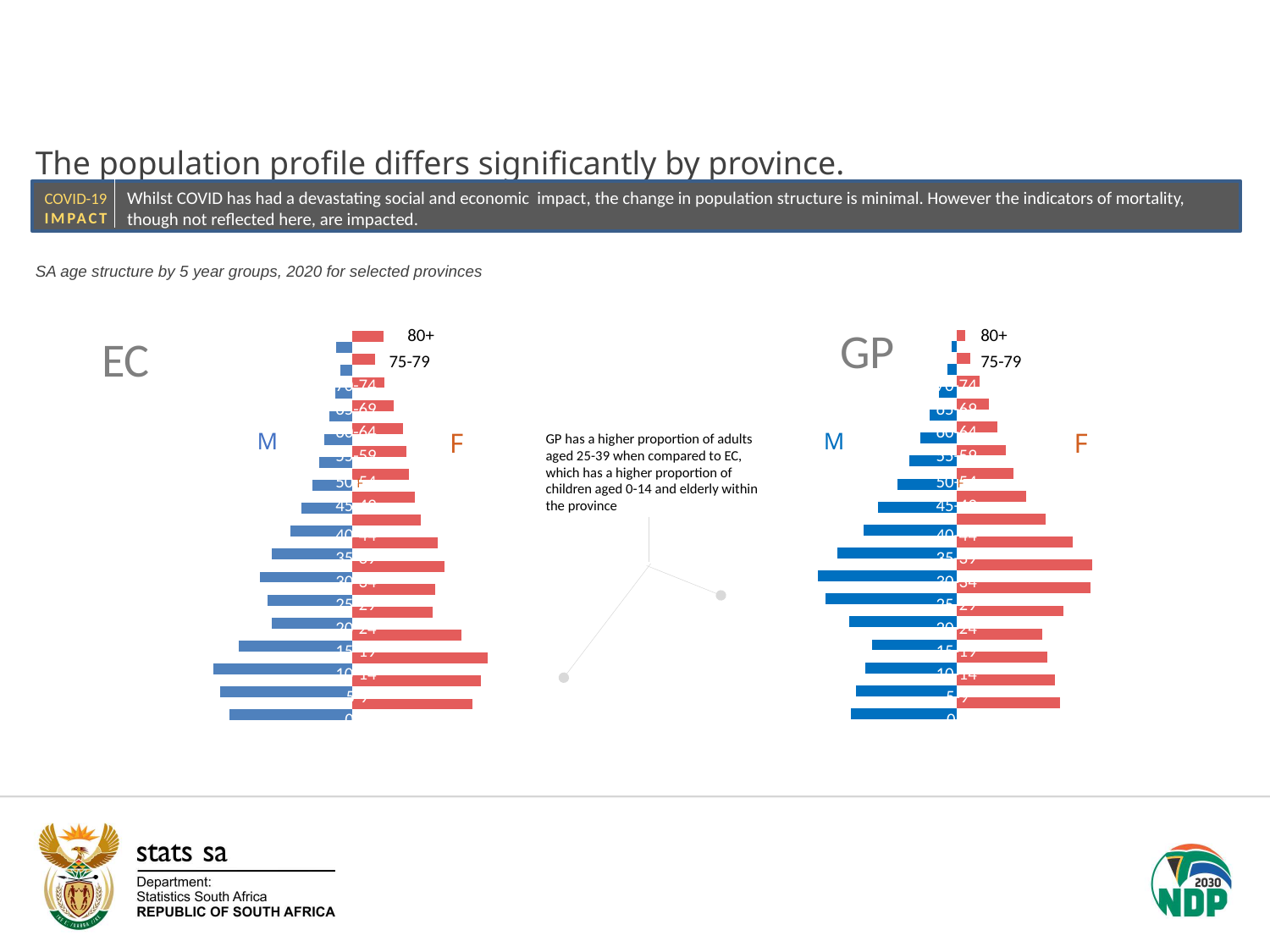
What is the title of the chart section on the slide? SA age structure by 5 year groups, 2020 for selected provinces In the GP chart, is the F bar for 80+ longer or shorter than the F bar for 75-79? shorter In the GP chart, do the bars get longer or shorter moving from the 75-79 group up to the 80+ group? shorter In the EC chart, is the M bar for 75-79 longer or shorter than the M bar for the bottom (youngest) age group? shorter In the GP chart, which age group has the shortest bars? 80+ In the EC chart, which age group has the longest M (male) bar? 10-14 What type of chart is used for the EC population profile? bar chart How many series (sexes) are plotted in the GP chart? 2 Which two provinces are shown in the charts? EC and GP Which colour represents the F (female) series in both charts? red How many age groups are plotted in the EC chart? 17 In the EC chart, which age group has the shortest bars? 75-79